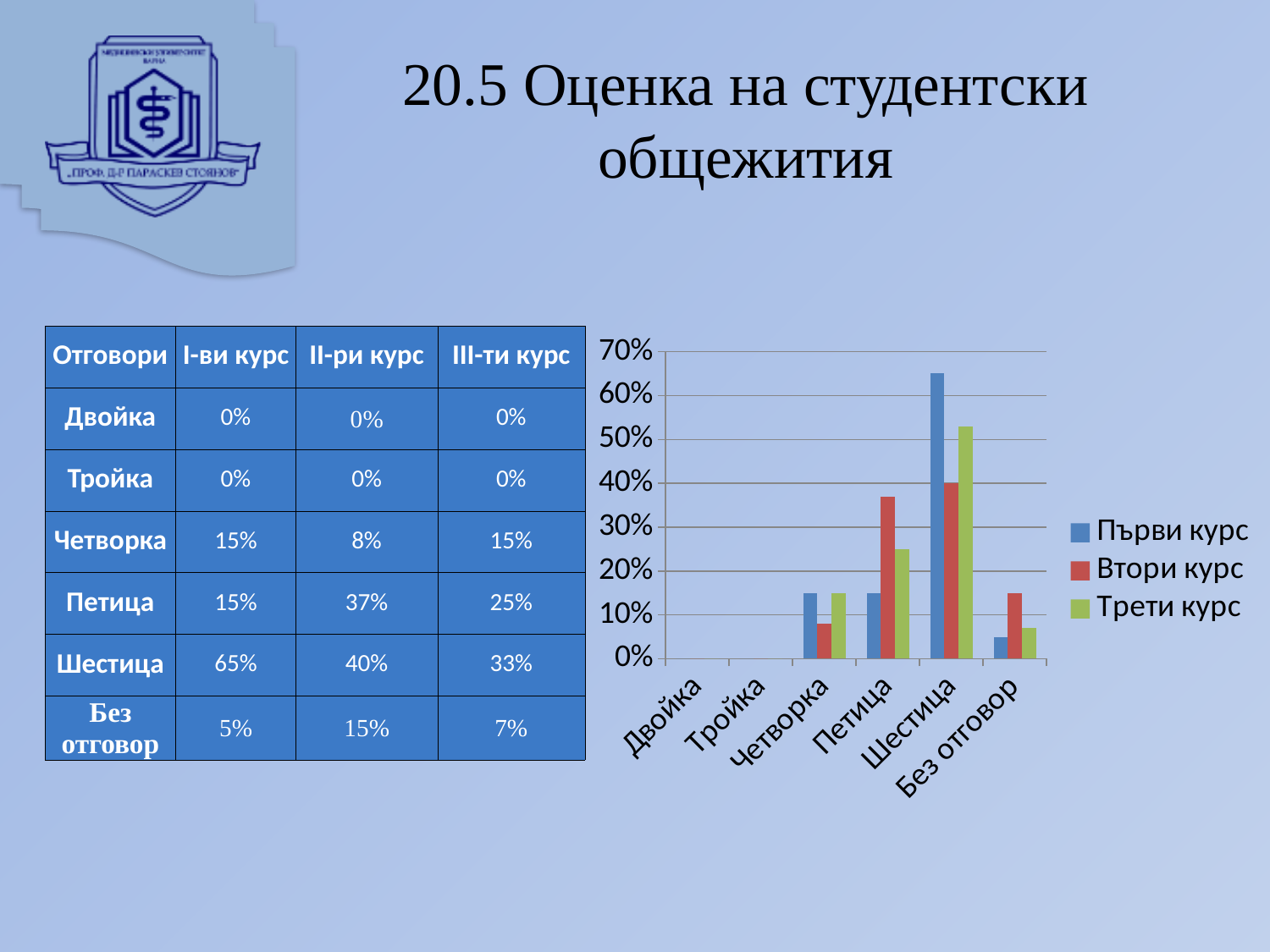
Is the value for Втори курс at Петица greater or less than 30%? greater Is the value for Първи курс at Шестица greater or less than 60%? greater How many categories are shown on the x axis of the chart? 6 Is the value for Трети курс at Петица greater or less than 30%? less How many series does the chart legend list? 3 What kind of chart is shown on the slide? bar chart At Без отговор, which series has the larger value: Първи курс or Втори курс? Втори курс At Петица, which series has the larger value: Първи курс or Втори курс? Втори курс What is the value for Първи курс at Шестица, as printed in the table on the slide? 65% What is the value for Втори курс at Петица, as printed in the table on the slide? 37% Which category has the highest value for Първи курс? Шестица Which category has the highest value for Втори курс? Шестица